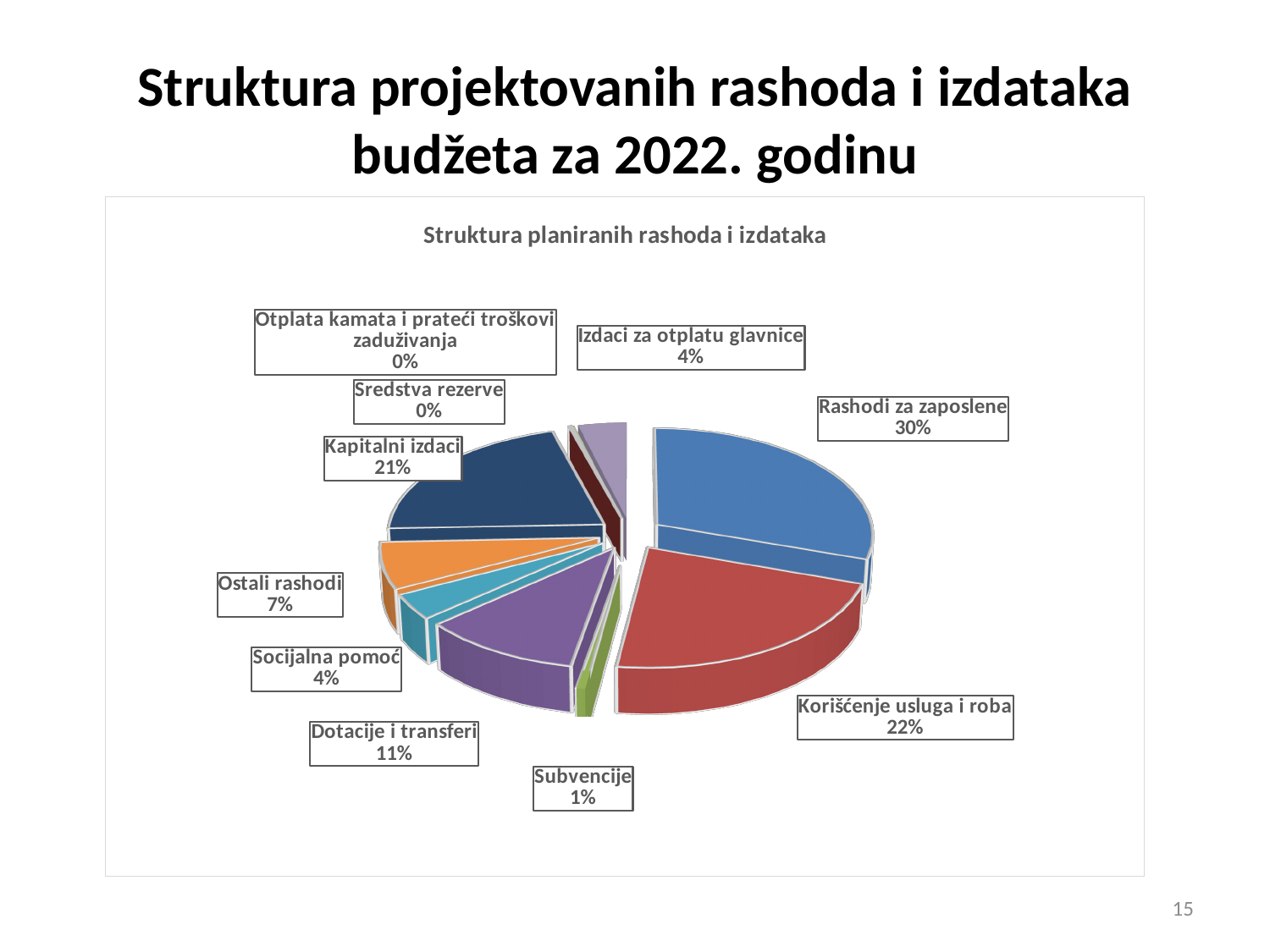
Which is larger, Ostali rashodi or Socijalna pomoć? Ostali rashodi How many categories are shown in the pie chart? 10 Which category has the largest share of the pie? Rashodi za zaposlene What is the title of the chart? Struktura planiranih rashoda i izdataka What percentage is shown for Dotacije i transferi? 11% What percentage is shown for Korišćenje usluga i roba? 22% What percentage is shown for Kapitalni izdaci? 21% What percentage is shown for Sredstva rezerve? 0% What share of the pie does Rashodi za zaposlene represent? 30% What is the difference in percentage points between Rashodi za zaposlene and Korišćenje usluga i roba? 8 percentage points What type of chart is shown on the slide? Pie chart What percentage is shown for Subvencije? 1%